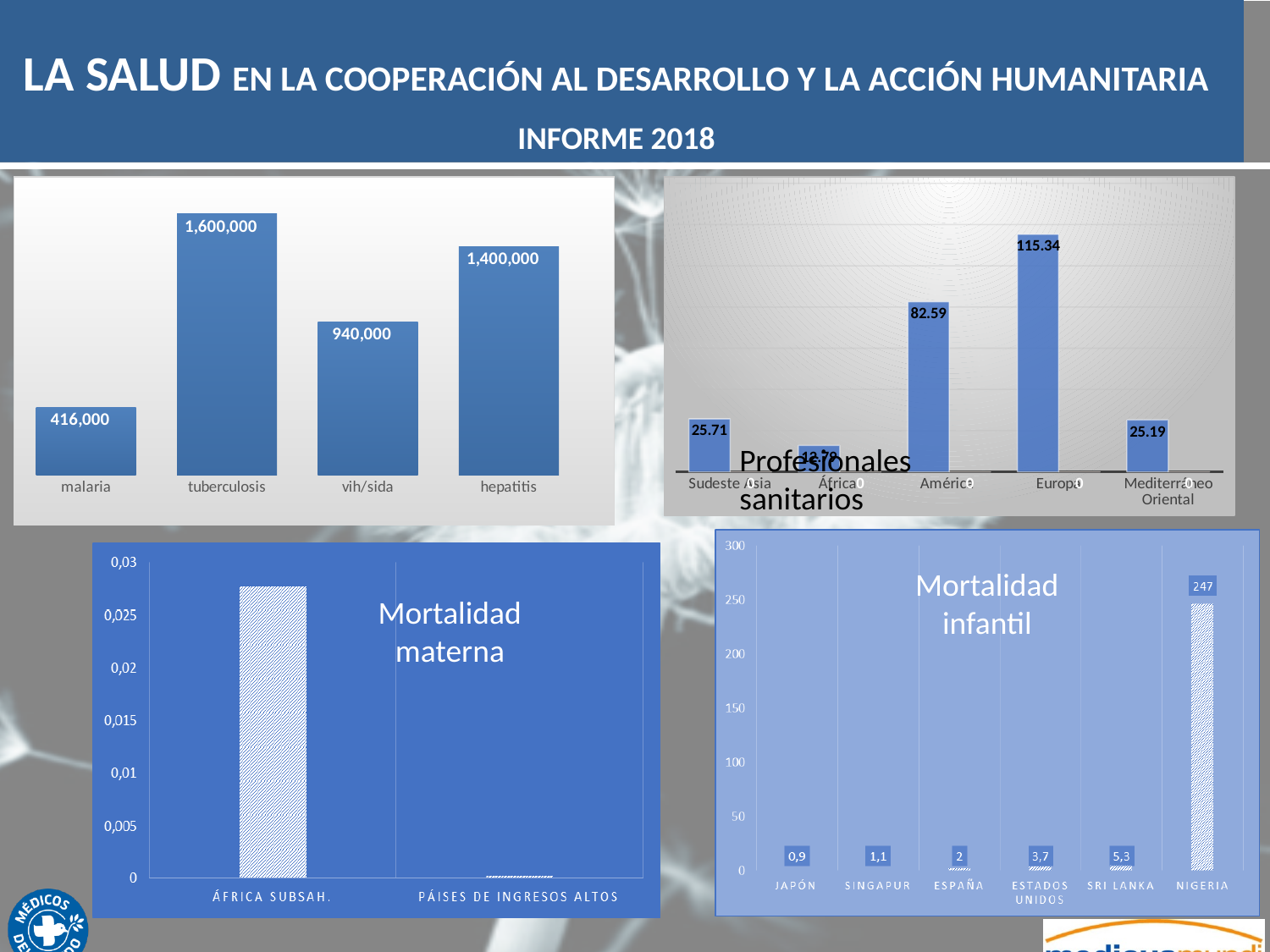
In the Mortalidad infantil chart, which country has the lowest value? Japón In the Mortalidad infantil chart, how many countries are shown? 6 In the Profesionales sanitarios chart, which region has the highest value? Europa In the Mortalidad infantil chart, what is the value for Nigeria? 247 In the top-left chart, how many categories are shown? 4 In the Profesionales sanitarios chart, which is larger, the value for Sudeste Asia or the value for Mediterráneo Oriental? Sudeste Asia In the top-left chart, which category has the lowest value? malaria In the top-left chart, what is the value for tuberculosis? 1,600,000 In the top-left chart, what is the difference between the values for hepatitis and vih/sida? 460,000 What type of chart is the Mortalidad materna chart? bar chart In the Mortalidad materna chart, is the value for África Subsah. greater or less than 0,02? greater In the Profesionales sanitarios chart, what is the value for Europa? 115.34